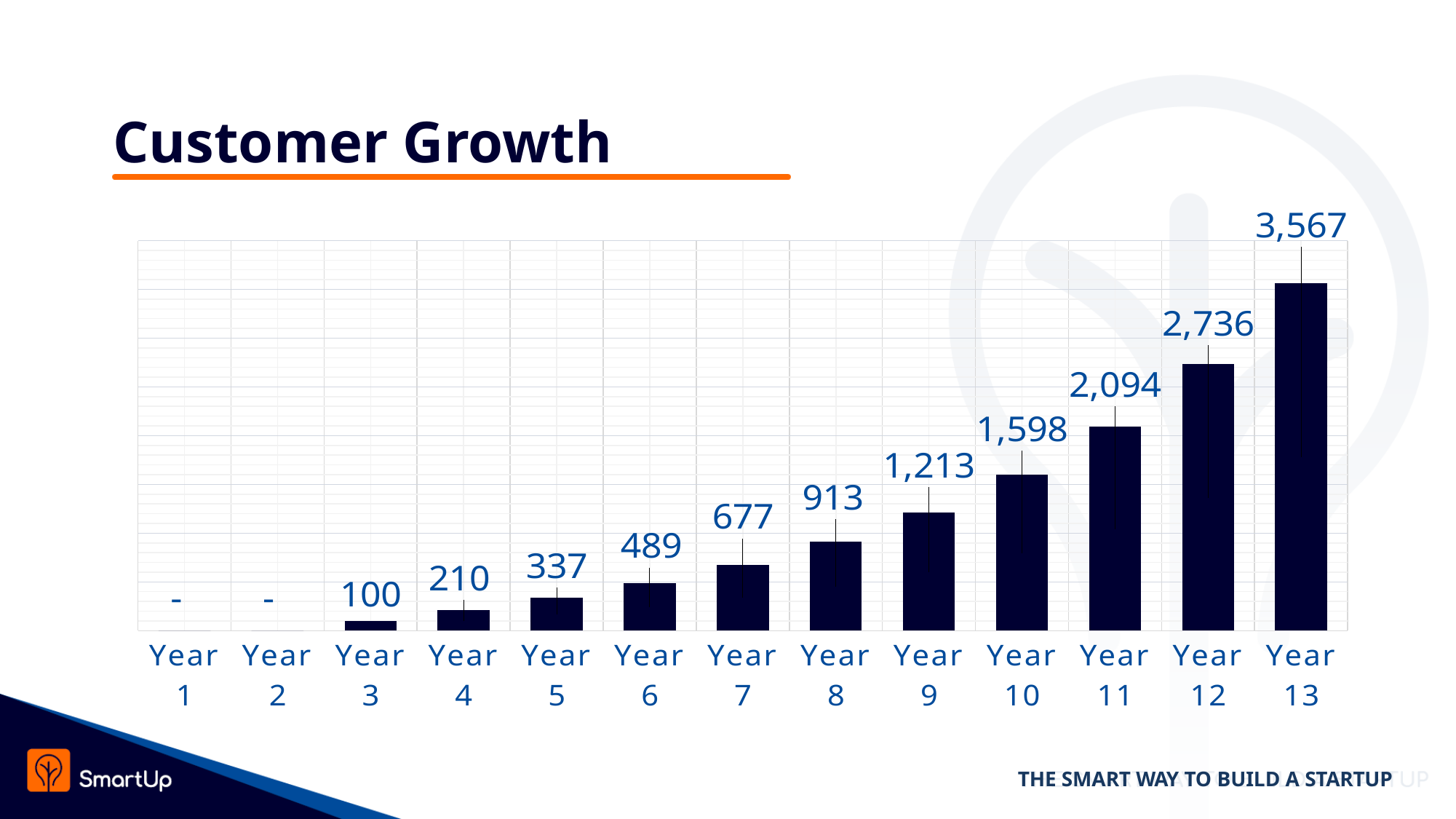
Which year has the highest value? Year 13 What kind of chart is shown on the slide? Bar chart What is the difference between the values for Year 9 and Year 8? 300 What is the value for Year 7? 677 Which is larger, the value for Year 10 or the value for Year 11? Year 11 How many years are shown on the x axis? 13 What is the value for Year 3? 100 Do the values rise or fall from Year 3 to Year 13? Rise What is the value for Year 13? 3,567 What label is shown above the bars for Year 1 and Year 2? - What is the title of the slide? Customer Growth What is the difference between the values for Year 13 and Year 12? 831